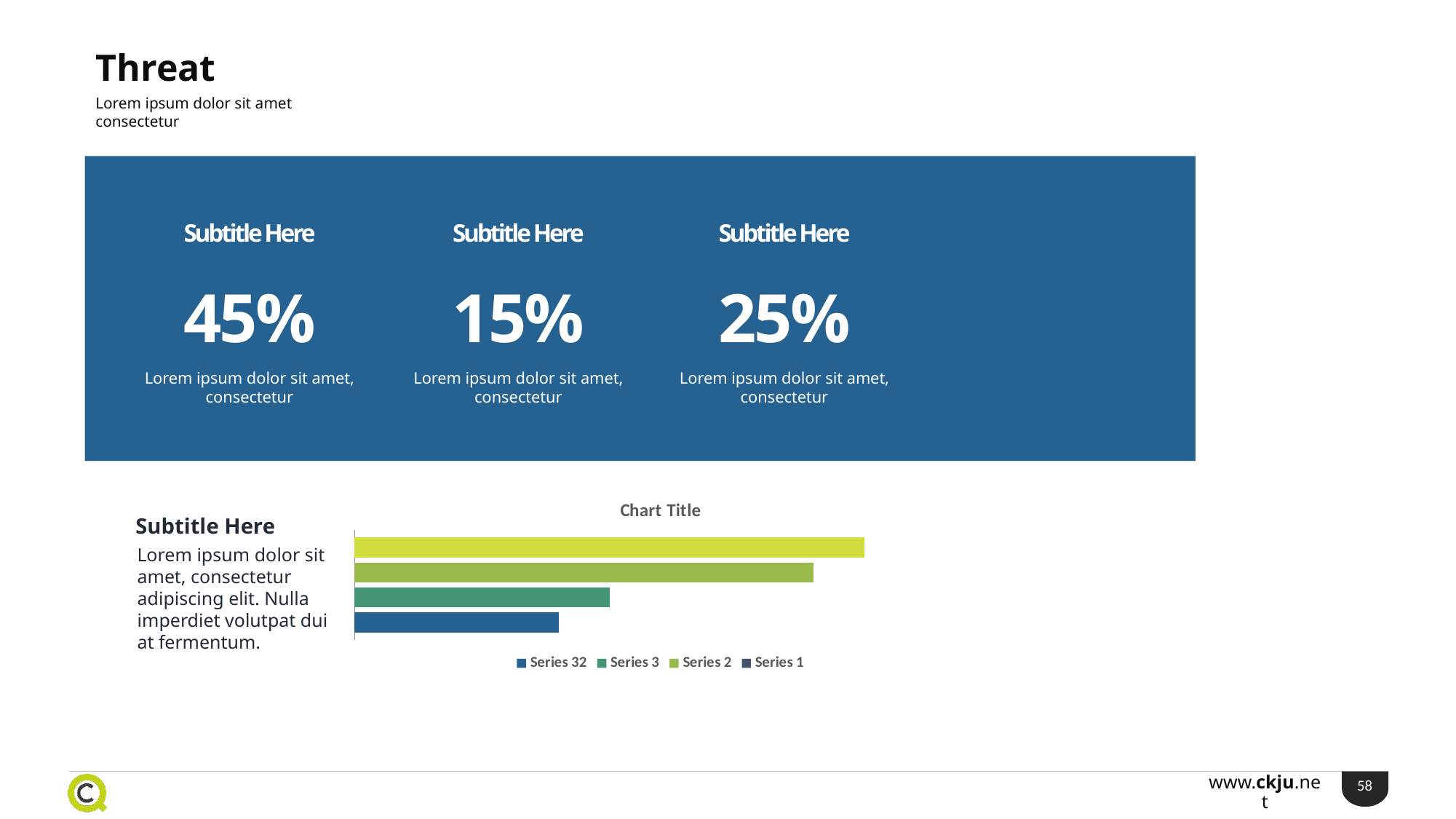
Which bar in the chart is the shortest: the top, second, third or bottom bar? the bottom bar What kind of chart is shown on the slide? bar chart Which is longer in the chart, the second bar from the top or the third bar from the top? the second bar from the top How many series does the chart legend list? 4 Do the bar lengths increase or decrease going from the top bar to the bottom bar? decrease What are the legend entries of the chart, in order? Series 32, Series 3, Series 2, Series 1 How many bars are plotted in the chart? 4 Which bar in the chart is the longest: the top, second, third or bottom bar? the top bar Which is longer in the chart, the top bar or the bottom bar? the top bar What is the title of the chart? Chart Title